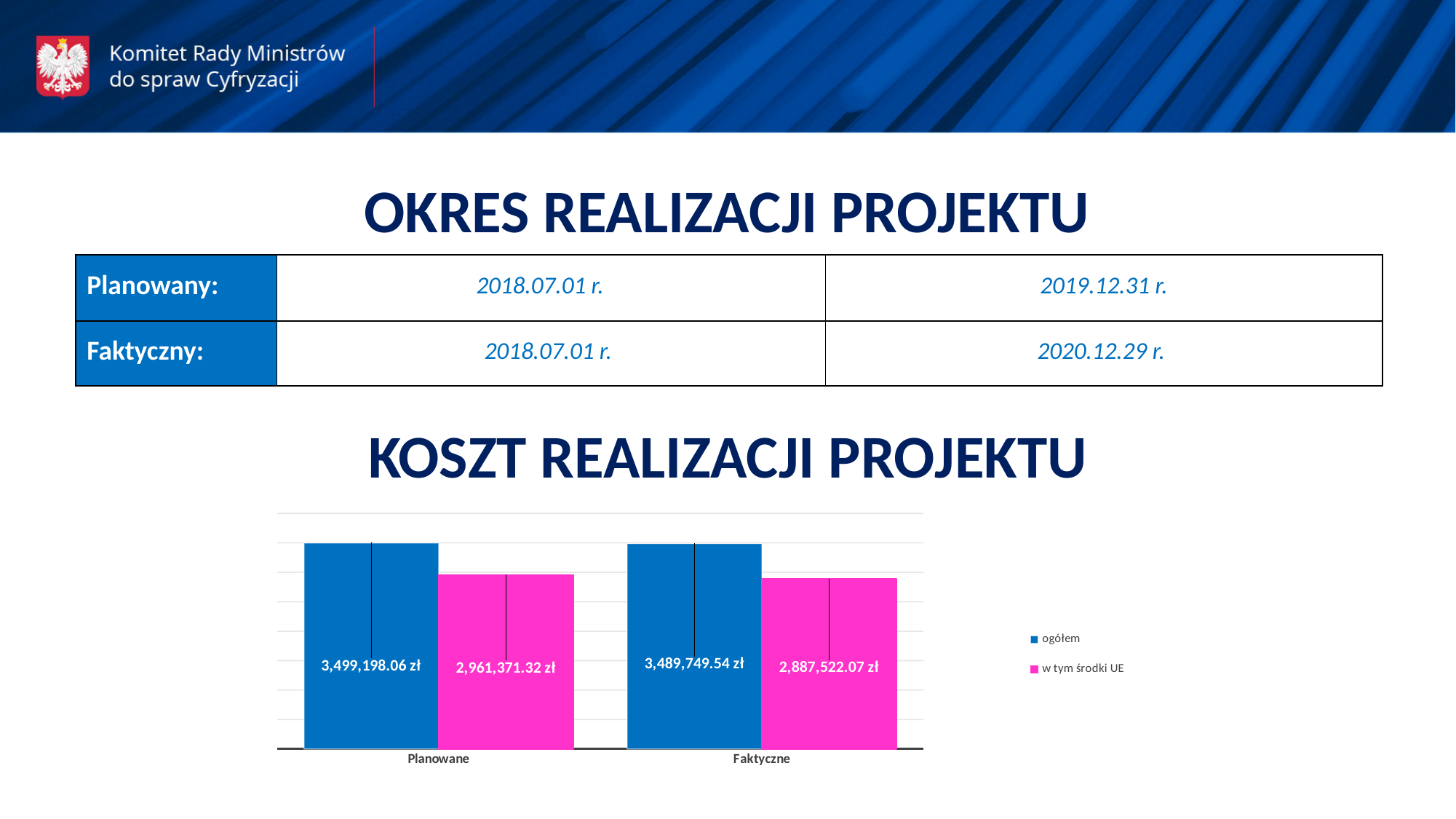
Which bar in the chart has the lowest value? w tym środki UE for Faktyczne What is the difference between the ogółem values for Planowane and Faktyczne? 9,448.52 zł What type of chart is shown under KOSZT REALIZACJI PROJEKTU? Bar chart What is the value of w tym środki UE for Faktyczne? 2,887,522.07 zł Which category has the higher ogółem value, Planowane or Faktyczne? Planowane How many series does the chart legend list? 2 What is the value of ogółem for Planowane? 3,499,198.06 zł What is the difference between the w tym środki UE values for Planowane and Faktyczne? 73,849.25 zł What is the difference between ogółem and w tym środki UE for Planowane? 537,826.74 zł How many categories are shown on the x axis of the chart? 2 What is the value of ogółem for Faktyczne? 3,489,749.54 zł What is the value of w tym środki UE for Planowane? 2,961,371.32 zł